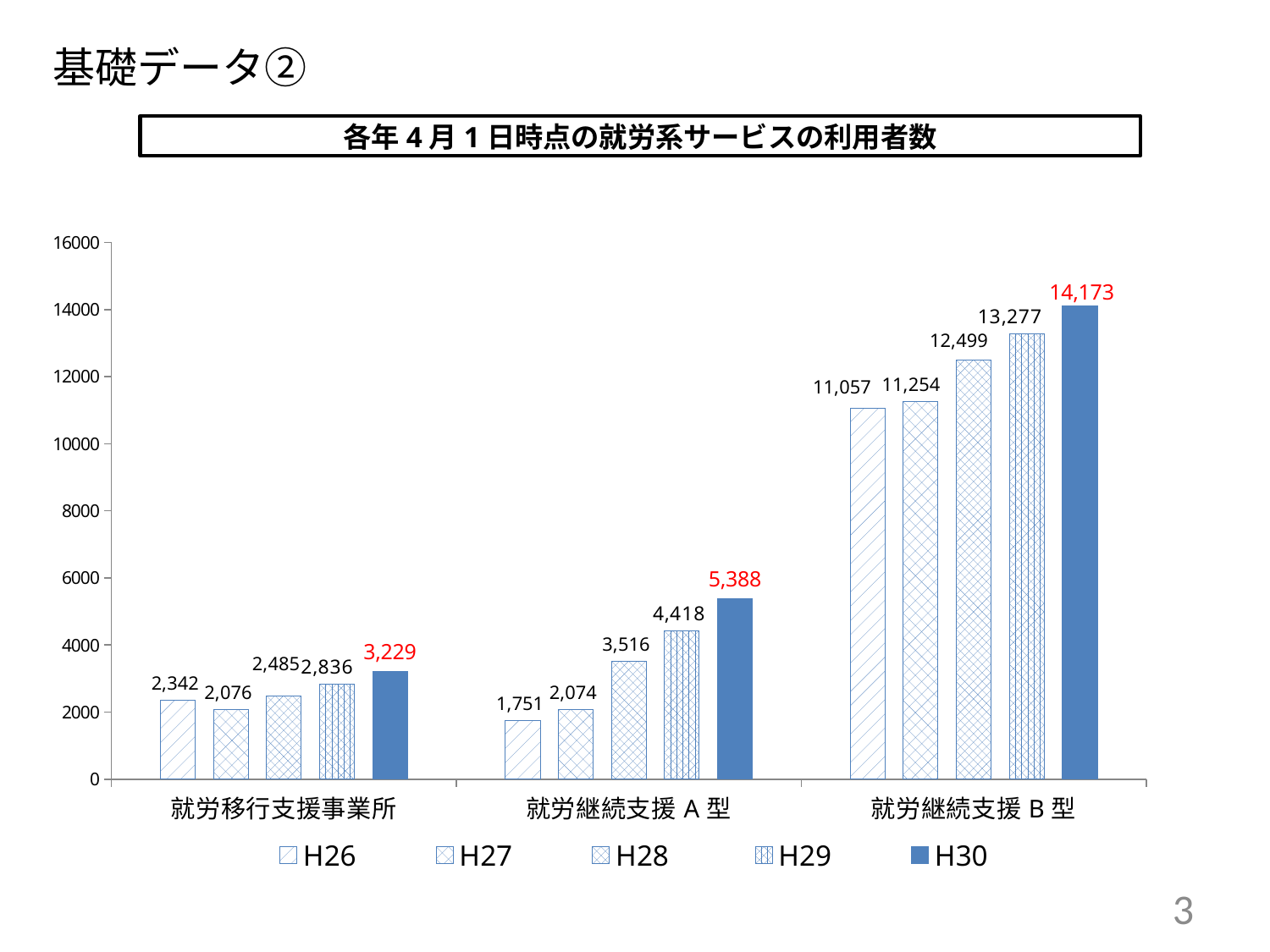
What is the value for H26 in the 就労移行支援事業所 category? 2,342 Is the H29 value for 就労継続支援Ｂ型 greater or less than 12000? greater How many categories are shown on the x axis? 3 Which series has the lowest value in the 就労移行支援事業所 category? H27 What is the value for H28 in the 就労継続支援Ａ型 category? 3,516 How many series does the legend list? 5 Do the values for 就労継続支援Ｂ型 rise or fall from H26 to H30? Rise What kind of chart is shown on the slide? Bar chart What is the difference between the H30 and H29 values in the 就労継続支援Ｂ型 category? 896 Which is larger in the 就労移行支援事業所 category: the H26 value or the H27 value? H26 What is the value for H30 in the 就労継続支援Ｂ型 category? 14,173 Which series has the highest value in the 就労継続支援Ａ型 category? H30